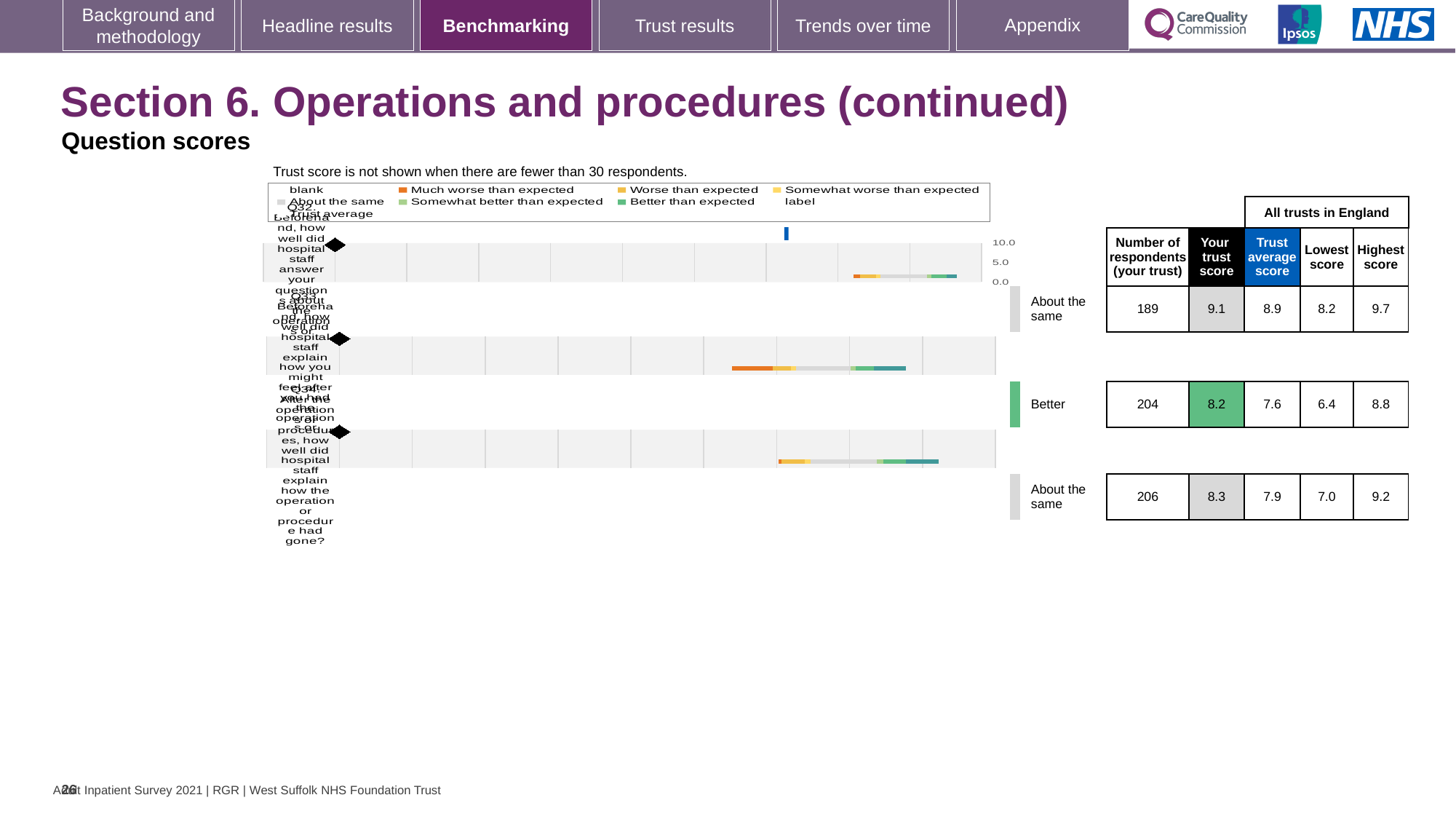
What is the highest score across all trusts in England for the third question row? 9.2 What is the trust average score for the second question row? 7.6 For the second question row, what is the difference between 'Your trust score' and the trust average score? 0.6 What is the 'Your trust score' value for the first question row? 9.1 For the third question row, which is larger: 'Your trust score' or the trust average score? Your trust score (8.3) How many question rows are plotted in the chart? 3 What kind of chart is used to show the question scores? Bar chart Which question row has the highest 'Your trust score'? The first row (9.1) What benchmark category label is shown next to the second question row? Better What is the lowest score across all trusts in England for the first question row? 8.2 Which question row has the lowest 'Lowest score' value? The second row (6.4) How many respondents does the table show for the first question row? 189